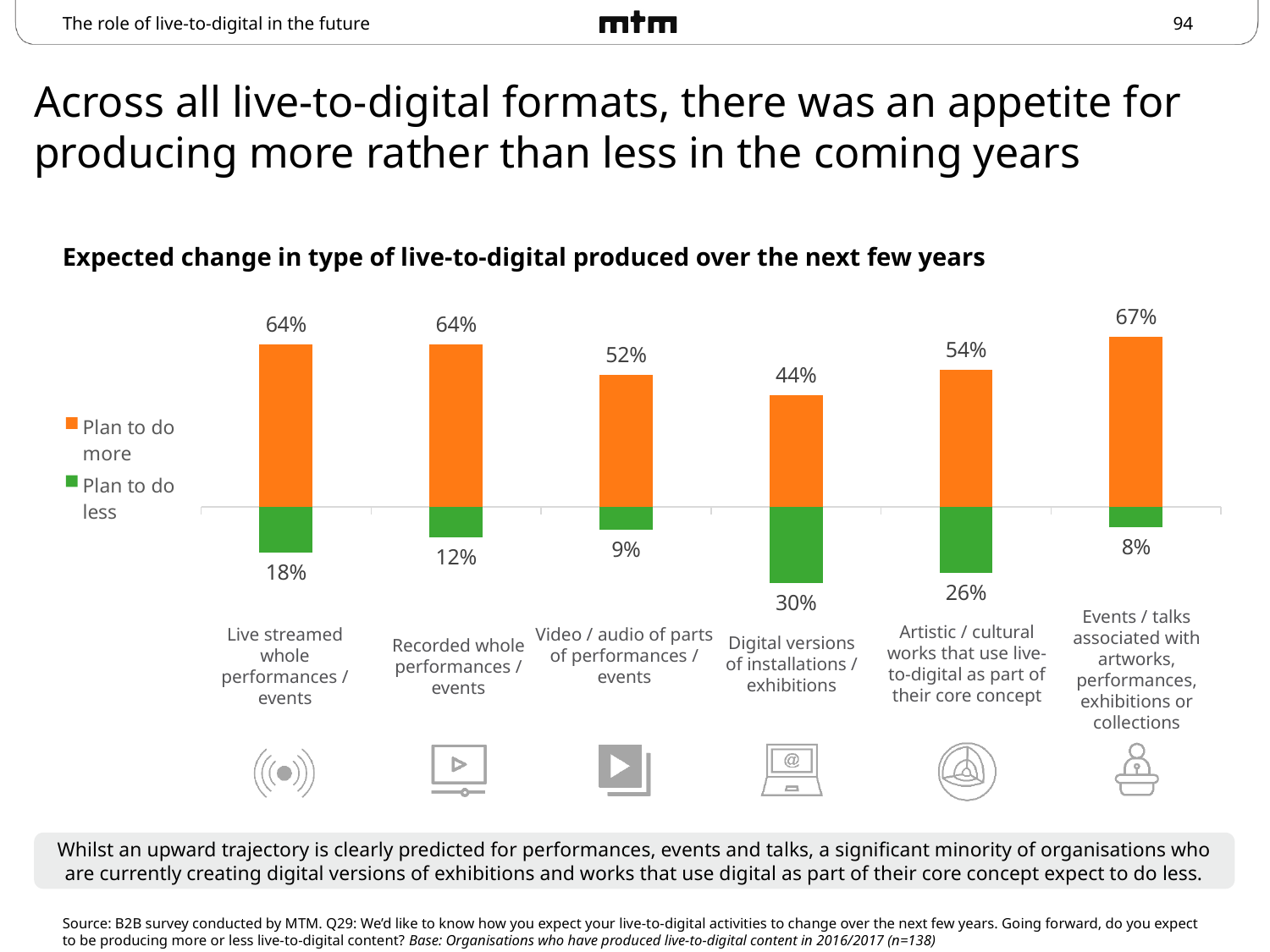
What colour represents 'Plan to do less' in the chart? Green Which category has the highest 'Plan to do more' value? Events / talks associated with artworks, performances, exhibitions or collections How many series does the legend list? 2 What percentage plan to do more events / talks associated with artworks, performances, exhibitions or collections? 67% How many categories are shown on the chart? 6 What percentage of organisations plan to do more live streamed whole performances / events? 64% What is the difference between the 'Plan to do more' and 'Plan to do less' values for recorded whole performances / events? 52 percentage points What percentage of organisations plan to do less digital versions of installations / exhibitions? 30% Which is larger: the 'Plan to do less' value for digital versions of installations / exhibitions or for artistic / cultural works that use live-to-digital as part of their core concept? Digital versions of installations / exhibitions Which category has the lowest 'Plan to do more' value? Digital versions of installations / exhibitions What type of chart is shown on the slide? Bar chart Which category has the lowest 'Plan to do less' value? Events / talks associated with artworks, performances, exhibitions or collections